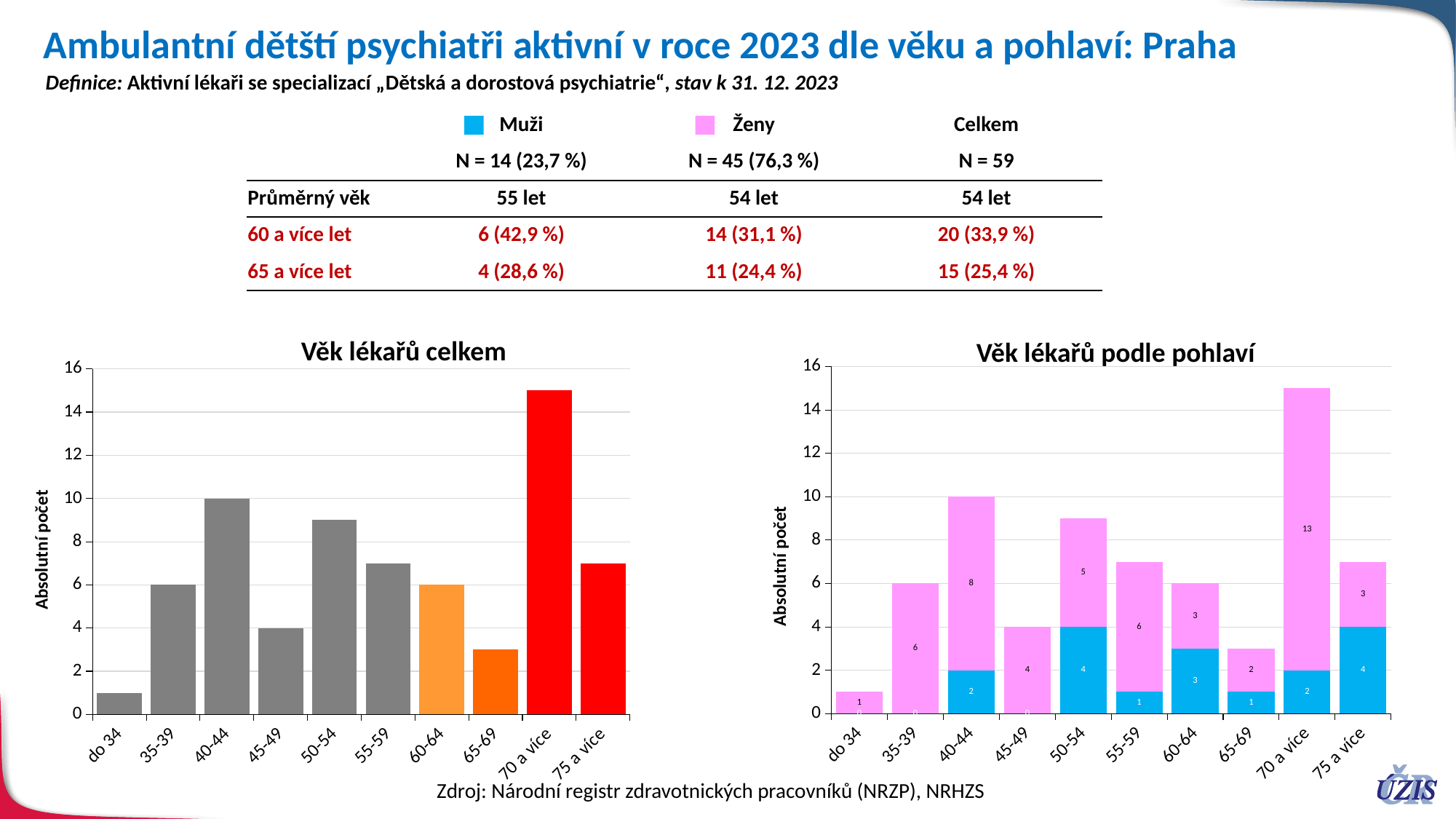
In the chart "Věk lékařů celkem", what is the value for the 40-44 category? 10 In the chart "Věk lékařů podle pohlaví", what is the value for Ženy in the 70 a více category? 13 In the chart "Věk lékařů celkem", which age category has the highest value? 70 a více In the chart "Věk lékařů celkem", which age category has the lowest value? do 34 In the chart "Věk lékařů celkem", is the value for 50-54 greater or less than 8? greater In the chart "Věk lékařů celkem", how many age categories are shown on the x axis? 10 In the chart "Věk lékařů podle pohlaví", what is the difference between the Ženy and Muži values in the 70 a více category? 11 In the chart "Věk lékařů podle pohlaví", which is larger in the 75 a více category, the Muži value or the Ženy value? Muži In the chart "Věk lékařů podle pohlaví", what is the total of the stacked bar for the 40-44 category? 10 In the chart "Věk lékařů podle pohlaví", what is the value for Muži in the 50-54 category? 4 What kind of chart is the chart titled "Věk lékařů celkem"? bar chart In the chart "Věk lékařů podle pohlaví", what colour represents Ženy? pink